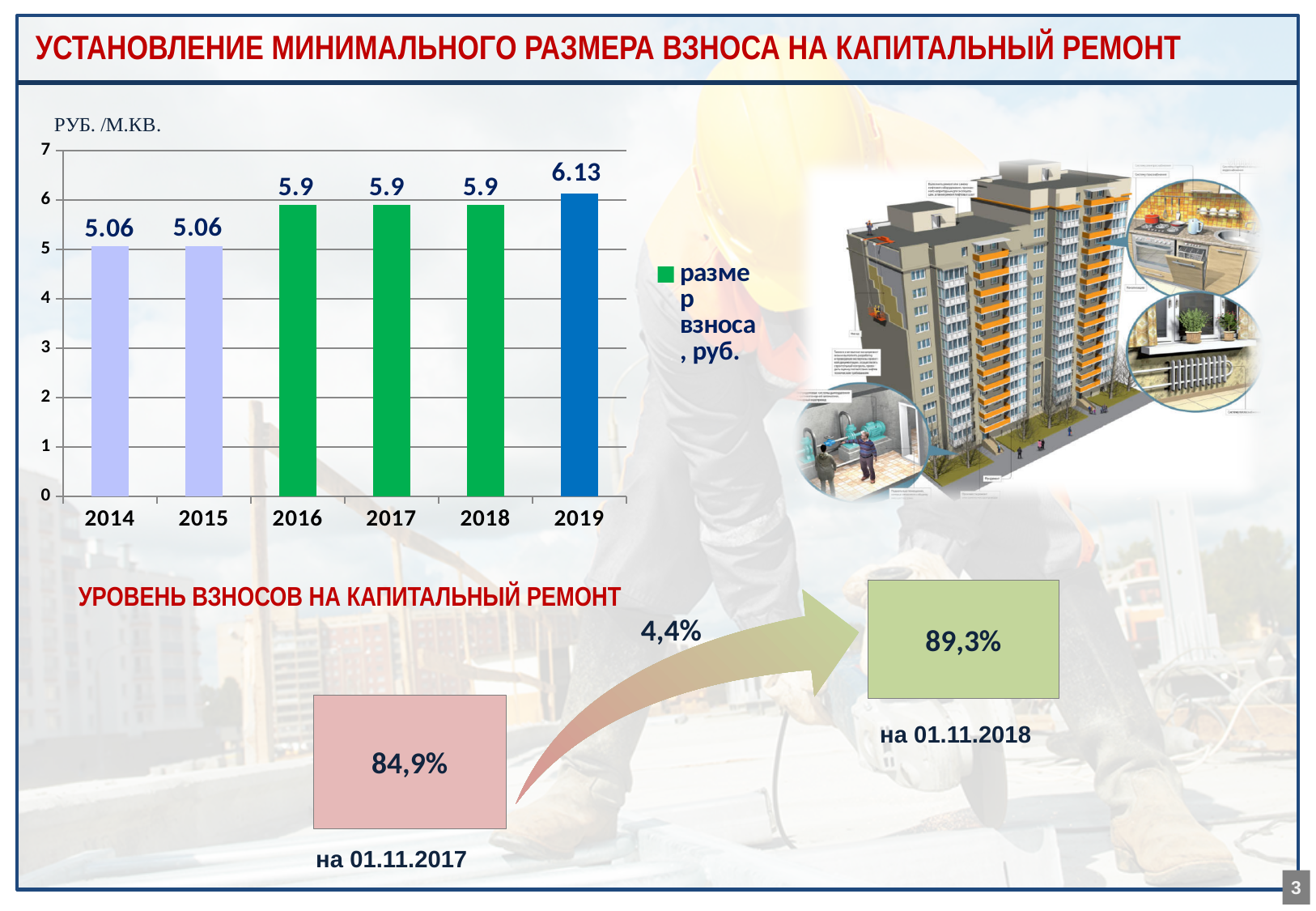
How many years are shown on the x axis of the bar chart? 6 Which year has the highest value in the bar chart? 2019 Do the values in the bar chart rise or fall from 2014 to 2019? rise Is the value for 2019 in the bar chart greater or less than 6? greater What is the value for 2017 in the bar chart? 5.9 What is the difference between the values for 2016 and 2015 in the bar chart? 0.84 What is the difference between the values for 2019 and 2018 in the bar chart? 0.23 Which is larger in the bar chart, the value for 2015 or the value for 2016? 2016 What kind of chart is shown on the slide? bar chart What is the value for 2014 in the bar chart? 5.06 How many series does the legend of the bar chart list? 1 What is the value for 2019 in the bar chart? 6.13